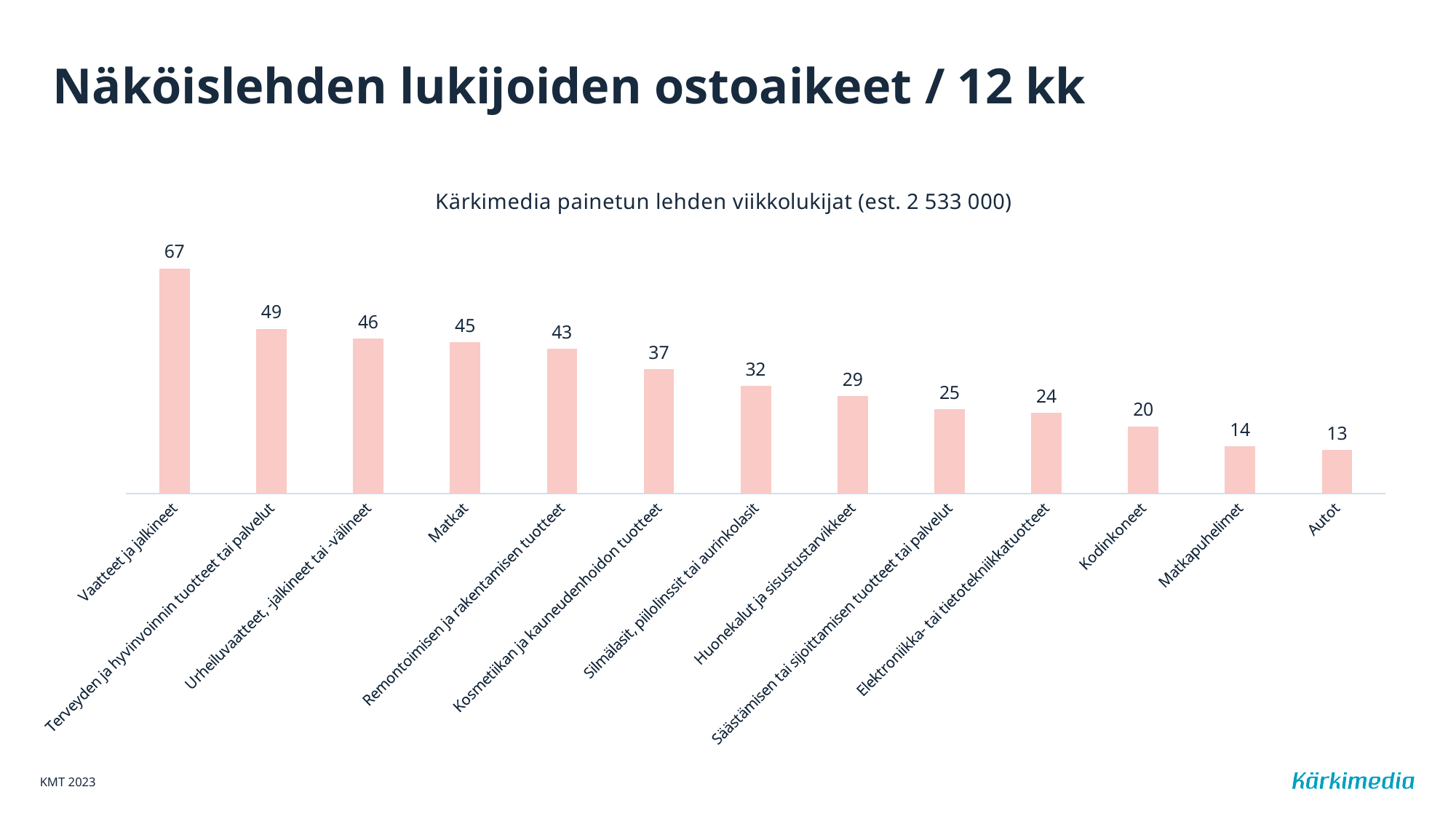
Which category has the lowest value? Autot Which is larger, the value for Huonekalut ja sisustustarvikkeet or the value for Matkapuhelimet? Huonekalut ja sisustustarvikkeet What kind of chart is shown on the slide? Bar chart What is the difference between the values for Matkat and Kosmetiikan ja kauneudenhoidon tuotteet? 8 What is the title of the chart? Kärkimedia painetun lehden viikkolukijat (est. 2 533 000) Which category has the highest value? Vaatteet ja jalkineet What is the value for Matkat? 45 What is the value for Vaatteet ja jalkineet? 67 What is the value for Silmälasit, piilolinssit tai aurinkolasit? 32 What is the difference between the values for Vaatteet ja jalkineet and Autot? 54 What is the value for Kodinkoneet? 20 How many categories are shown in the chart? 13